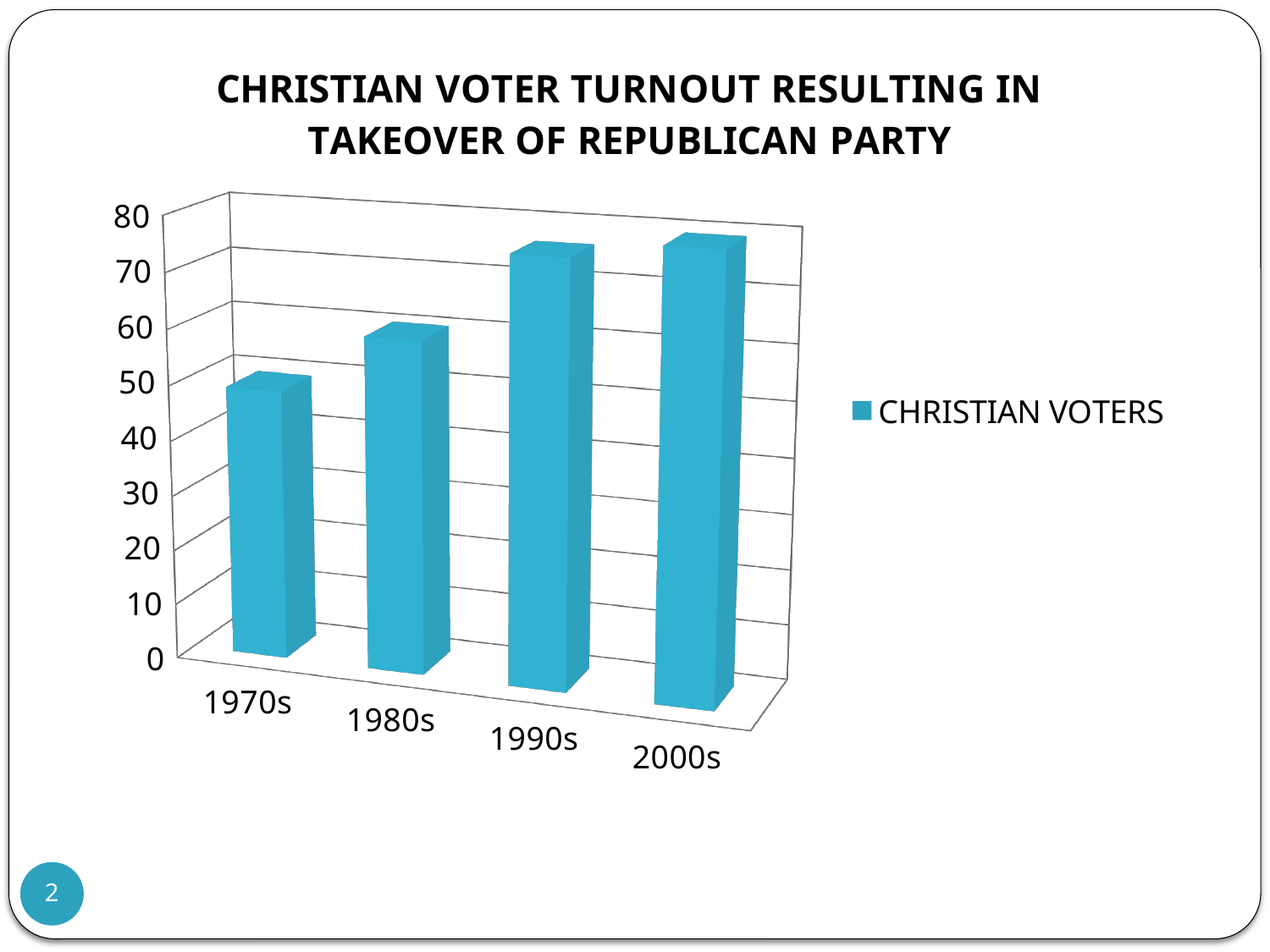
Is the value for the 1990s greater or less than 60? greater Is the value for the 1980s greater or less than 40? greater Do the values rise or fall from the 1970s to the 2000s? rise Which decade has the lowest value for Christian voters? 1970s What series name appears in the legend? CHRISTIAN VOTERS Which is larger, the value for the 1980s or the value for the 1990s? 1990s How many series does the legend list? 1 Is the value for the 2000s greater or less than 50? greater How many categories (decades) are shown on the x axis? 4 What kind of chart is shown on the slide? bar chart Which is larger, the value for the 1970s or the value for the 1980s? 1980s